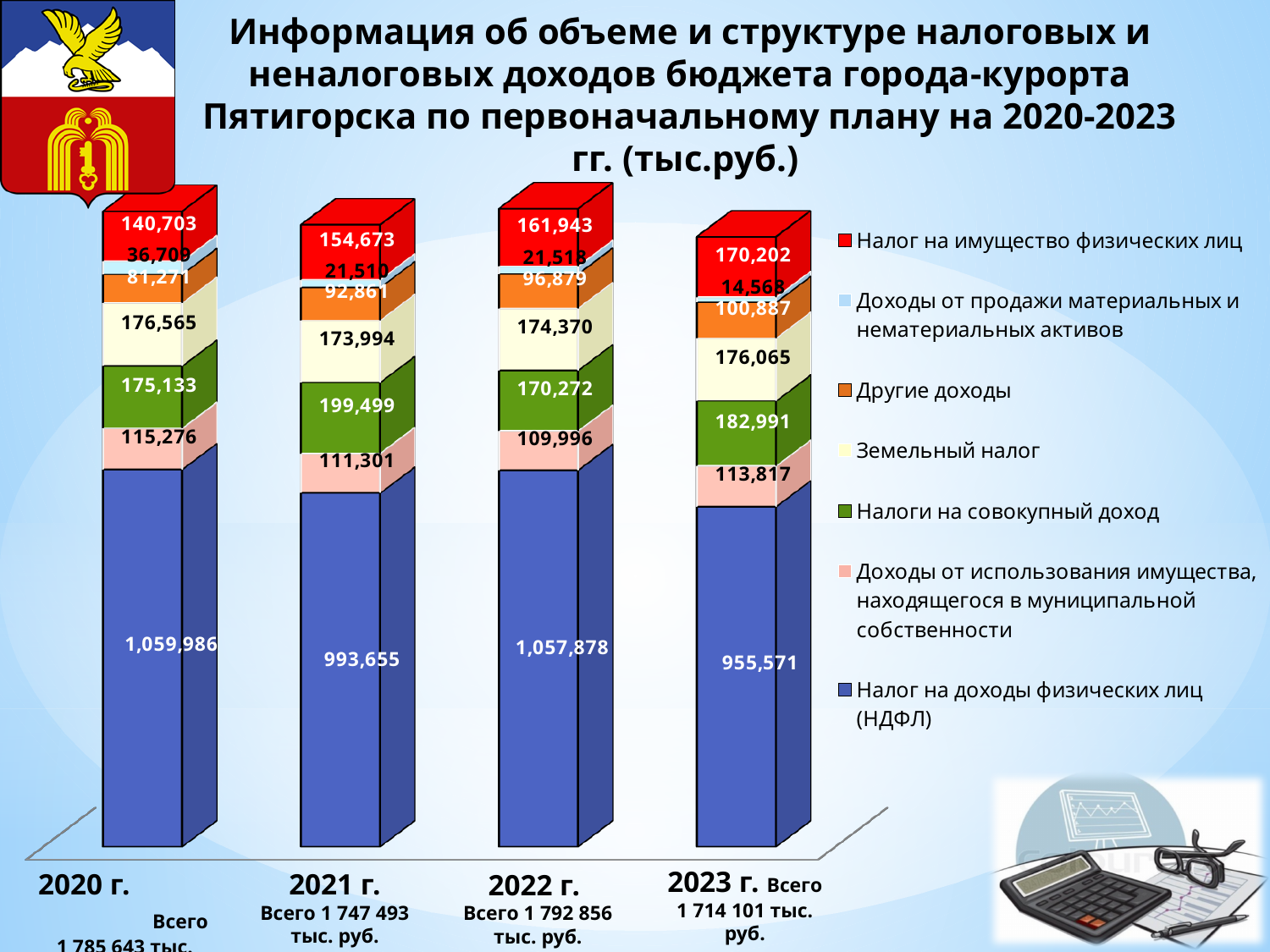
In which year is Налог на доходы физических лиц (НДФЛ) the lowest? 2023 г. What is the difference between Налог на имущество физических лиц in 2023 г. and in 2020 г.? 29,499 In which year is Налоги на совокупный доход the highest? 2021 г. What is the value of Земельный налог for 2022 г.? 174,370 What kind of chart is shown on the slide? Stacked bar chart What is the total (Всего) for 2022 г.? 1 792 856 тыс. руб. Does Налог на имущество физических лиц rise or fall from 2020 г. to 2023 г.? Rises How many series does the legend list? 7 Which is larger: Другие доходы in 2021 г. or in 2022 г.? 2022 г. How many years (bars) are shown in the chart? 4 What is the value of Доходы от продажи материальных и нематериальных активов for 2023 г.? 14,568 What is the value of Налог на доходы физических лиц (НДФЛ) for 2020 г.? 1,059,986